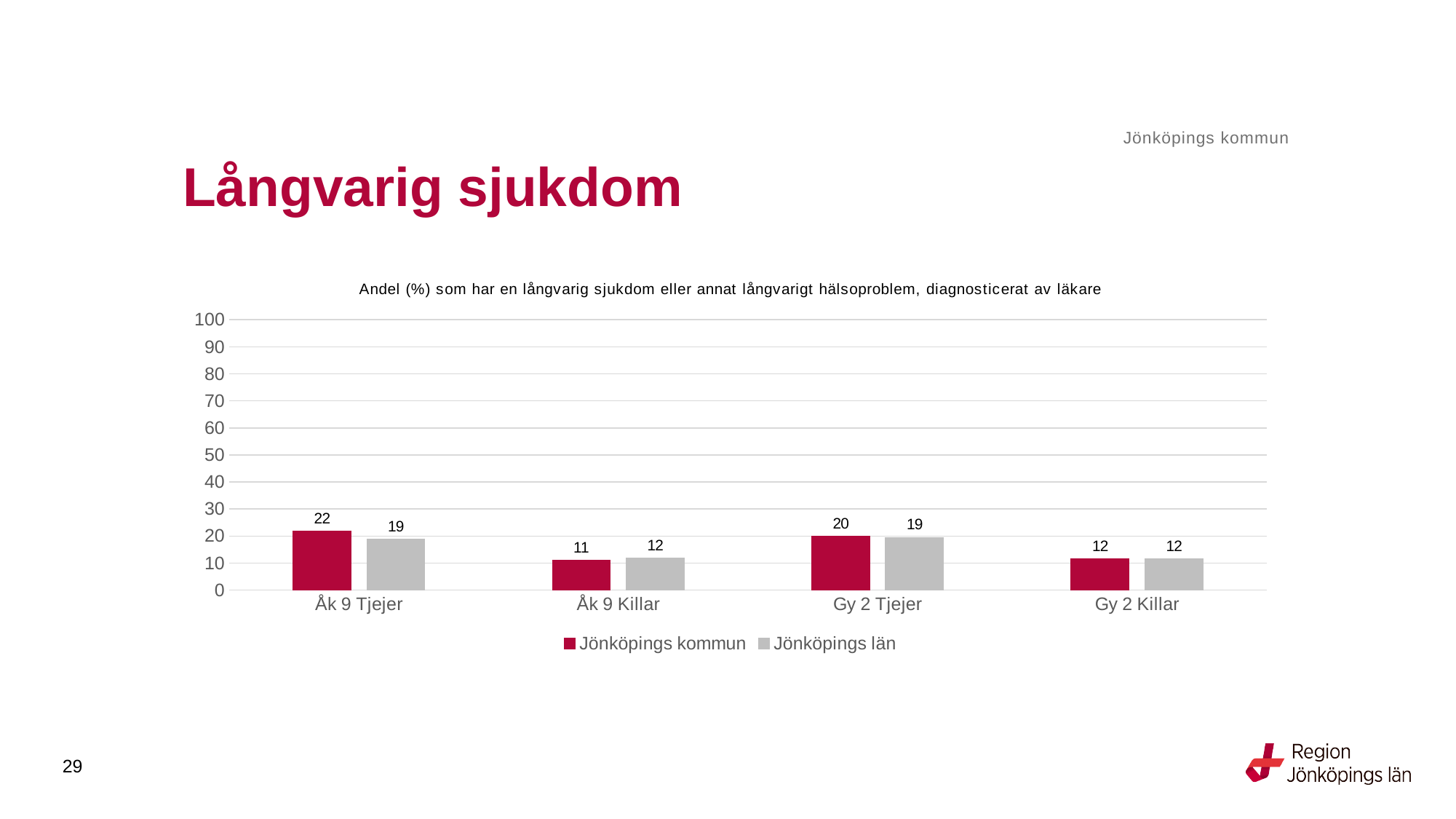
What is the value for Jönköpings län in the Gy 2 Tjejer category? 19 Which is larger for Åk 9 Killar: Jönköpings kommun or Jönköpings län? Jönköpings län What colour are the bars for Jönköpings län? grey Which category has the highest value for Jönköpings kommun? Åk 9 Tjejer What is the difference between the Jönköpings kommun and Jönköpings län values for Åk 9 Tjejer? 3 Is the value for Jönköpings kommun in Gy 2 Tjejer greater or less than 30? less Which category has the lowest value for Jönköpings kommun? Åk 9 Killar What is the value for Jönköpings kommun in the Åk 9 Killar category? 11 What kind of chart is shown on the slide? bar chart What is the value for Jönköpings kommun in the Åk 9 Tjejer category? 22 How many categories are shown on the x axis? 4 How many series does the legend list? 2